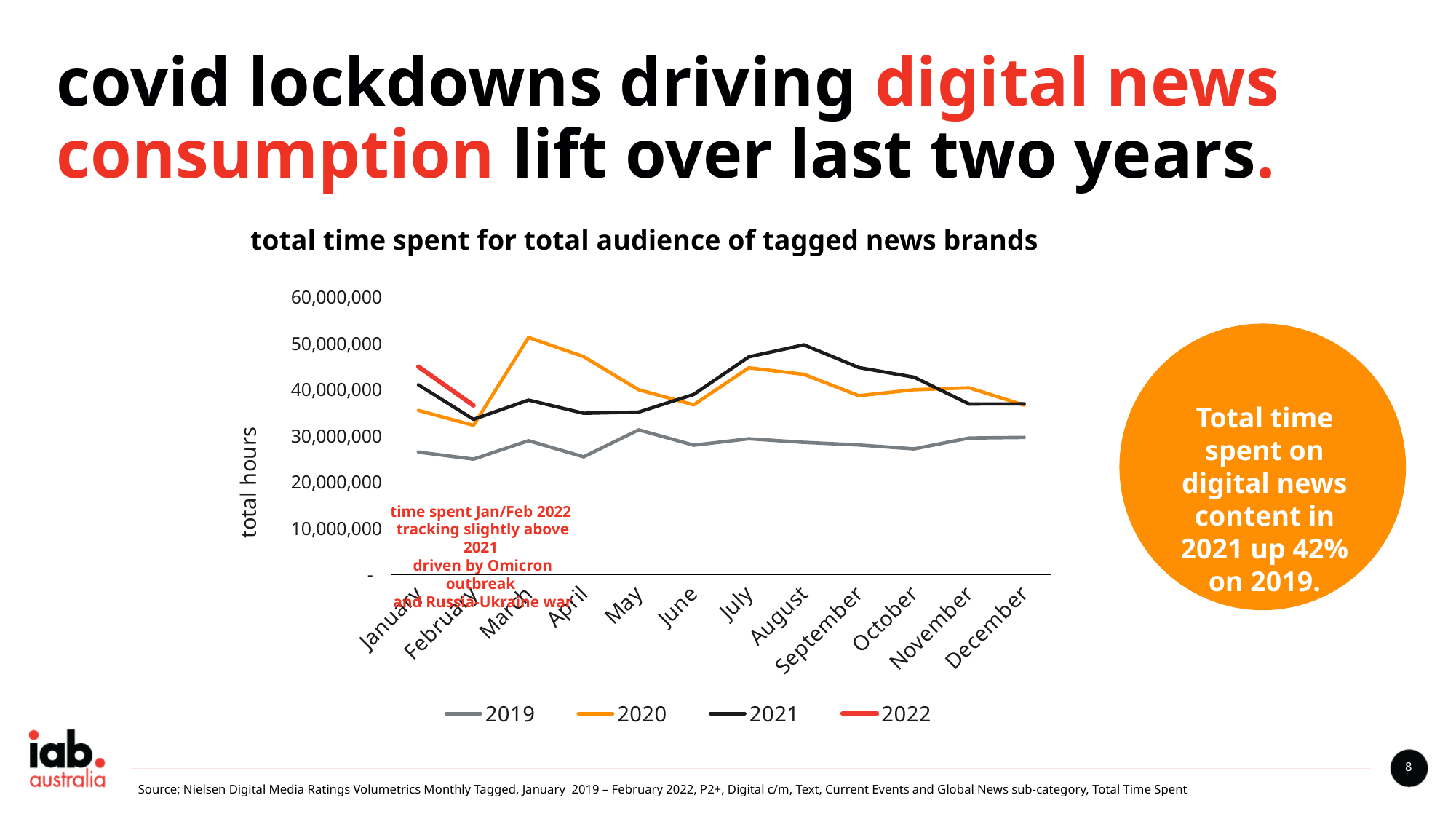
Does the 2020 series rise or fall from March to June? fall What is the label on the y axis? total hours What kind of chart is shown on the slide? line chart Which series has the lowest values across every month? 2019 What is the title of the chart? total time spent for total audience of tagged news brands How many series does the legend list? 4 Is the value for 2020 in March greater or less than 40,000,000? greater Which is larger in January: the 2022 value or the 2021 value? 2022 Is the value for 2019 in February greater or less than 30,000,000? less In which month does the 2020 series reach its highest value? March How many months are plotted along the x axis? 12 In which month does the 2021 series reach its highest value? August